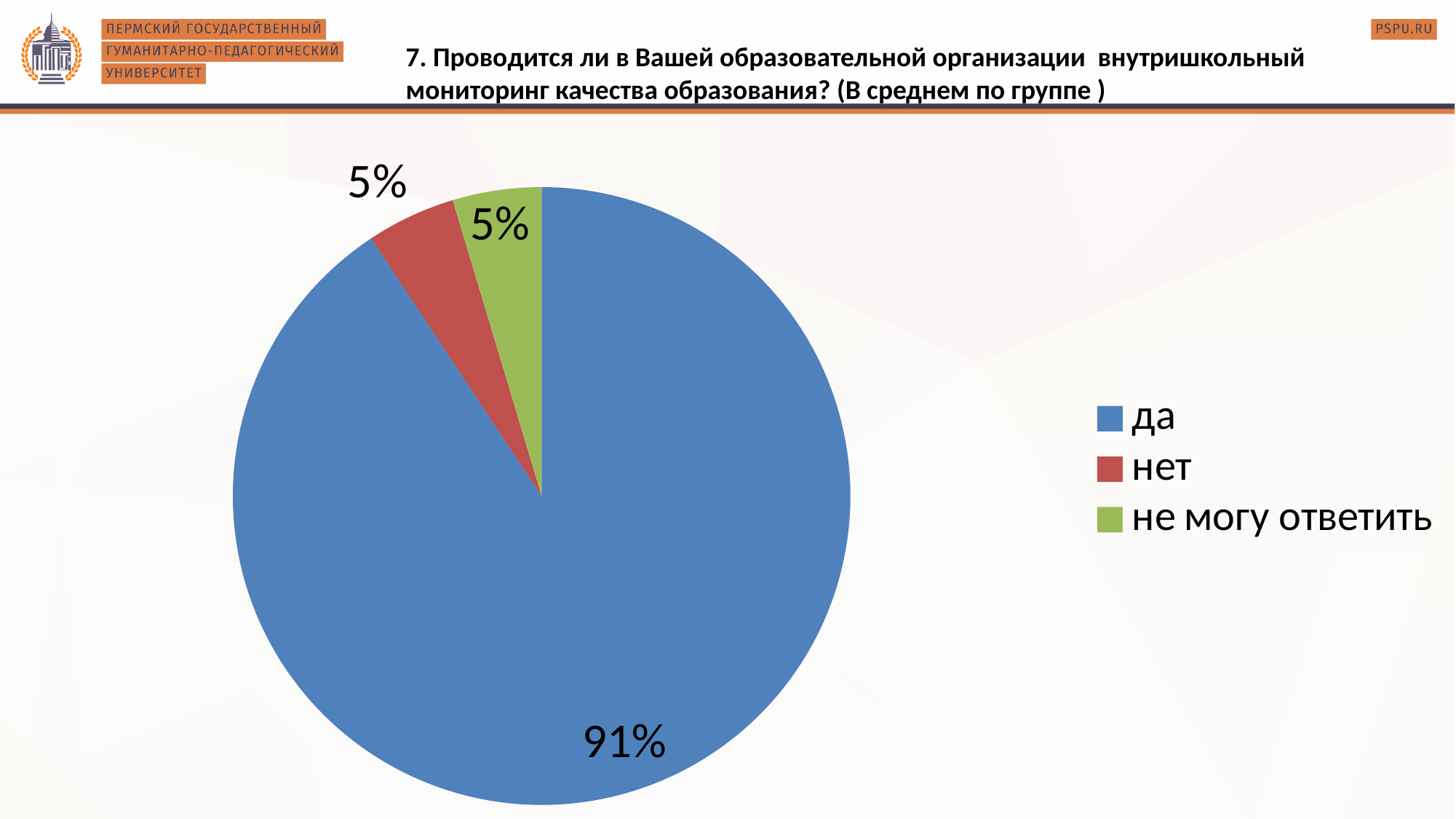
Which is larger, the slice for "да" or the slice for "нет"? да Which category has the largest slice of the pie? да What is the value shown for "не могу ответить"? 5% What colour is the slice for "не могу ответить"? green What colour is the slice for "да"? blue What is the value shown for "нет"? 5% How many slices does the pie chart have? 3 What type of chart is shown on the slide? pie chart What is the difference between the value for "да" and the value for "нет"? 86% What share of the pie does the "да" slice represent? 91% How many entries does the legend list? 3